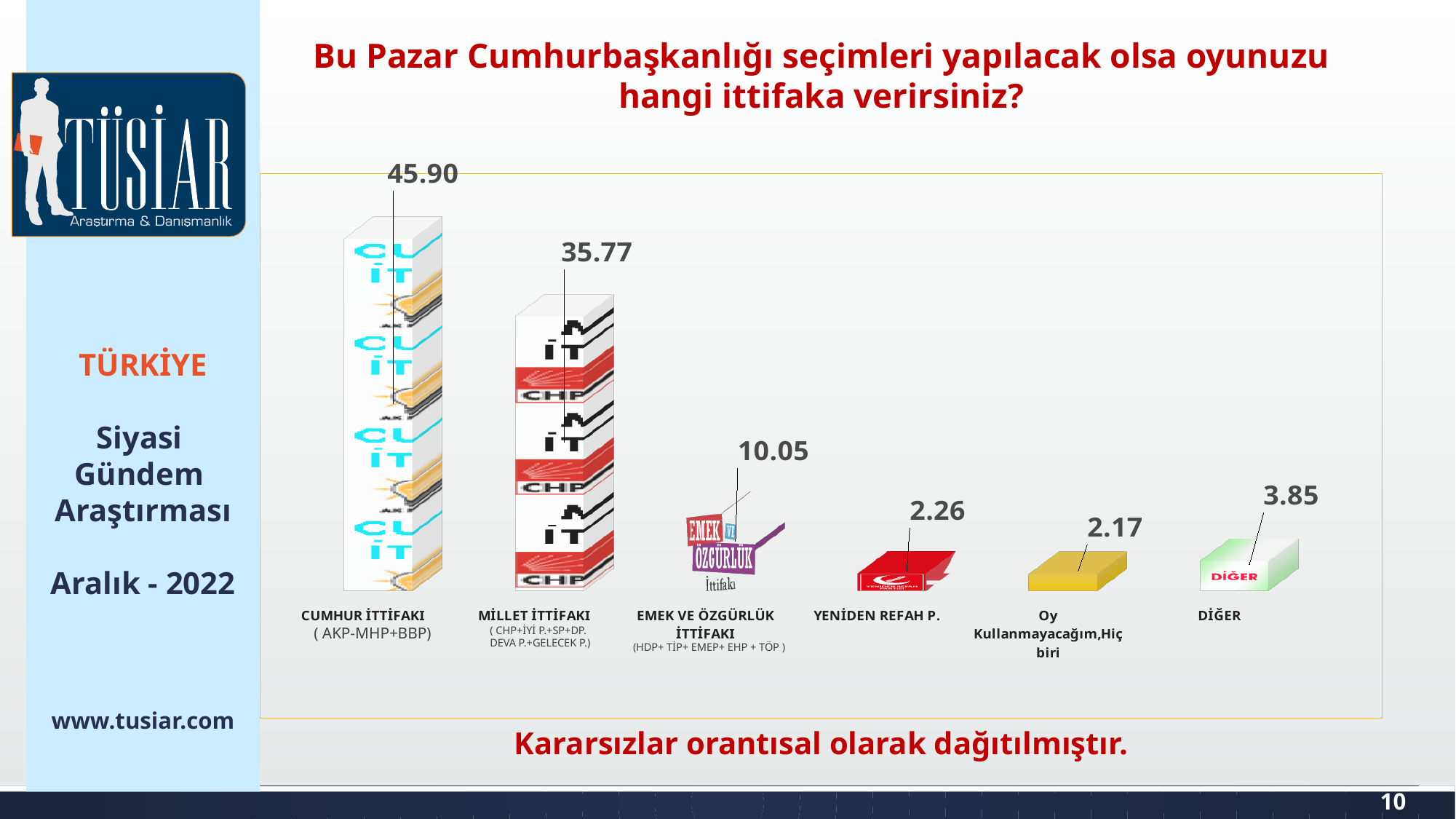
What is the value for DİĞER? 3.85 Which is larger, the value for DİĞER or the value for YENİDEN REFAH P.? DİĞER Which category has the highest value? CUMHUR İTTİFAKI What is the value for CUMHUR İTTİFAKI? 45.90 What is the value for MİLLET İTTİFAKI? 35.77 What is the value for YENİDEN REFAH P.? 2.26 What is the value for EMEK VE ÖZGÜRLÜK İTTİFAKI? 10.05 What kind of chart is shown on the slide? Bar chart Which category has the lowest value? Oy Kullanmayacağım,Hiç biri What is the difference between the values for CUMHUR İTTİFAKI and MİLLET İTTİFAKI? 10.13 How many categories are shown in the chart? 6 What is the title of the chart? Bu Pazar Cumhurbaşkanlığı seçimleri yapılacak olsa oyunuzu hangi ittifaka verirsiniz?